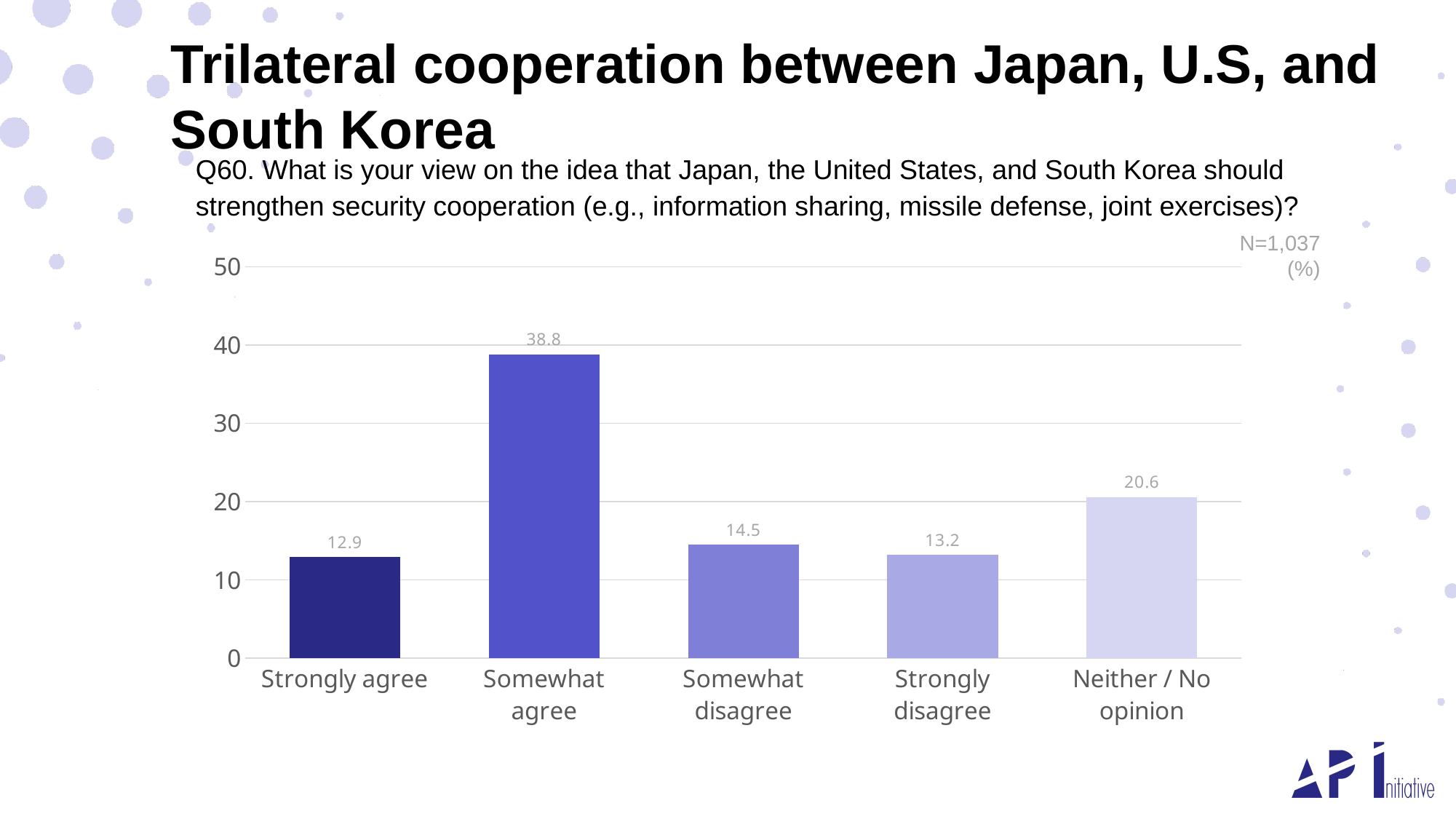
What is the sample size (N) shown on the chart? N=1,037 Which category has the lowest value? Strongly agree What kind of chart is shown on the slide? bar chart Which category has the highest value? Somewhat agree What is the value for Strongly agree? 12.9 What is the value for Neither / No opinion? 20.6 Which is larger, the value for Somewhat disagree or the value for Strongly disagree? Somewhat disagree What is the value for Somewhat agree? 38.8 How many categories are shown on the x axis? 5 Is the value for Neither / No opinion greater or less than 20? greater What is the difference between the values for Somewhat agree and Neither / No opinion? 18.2 What is the value for Strongly disagree? 13.2